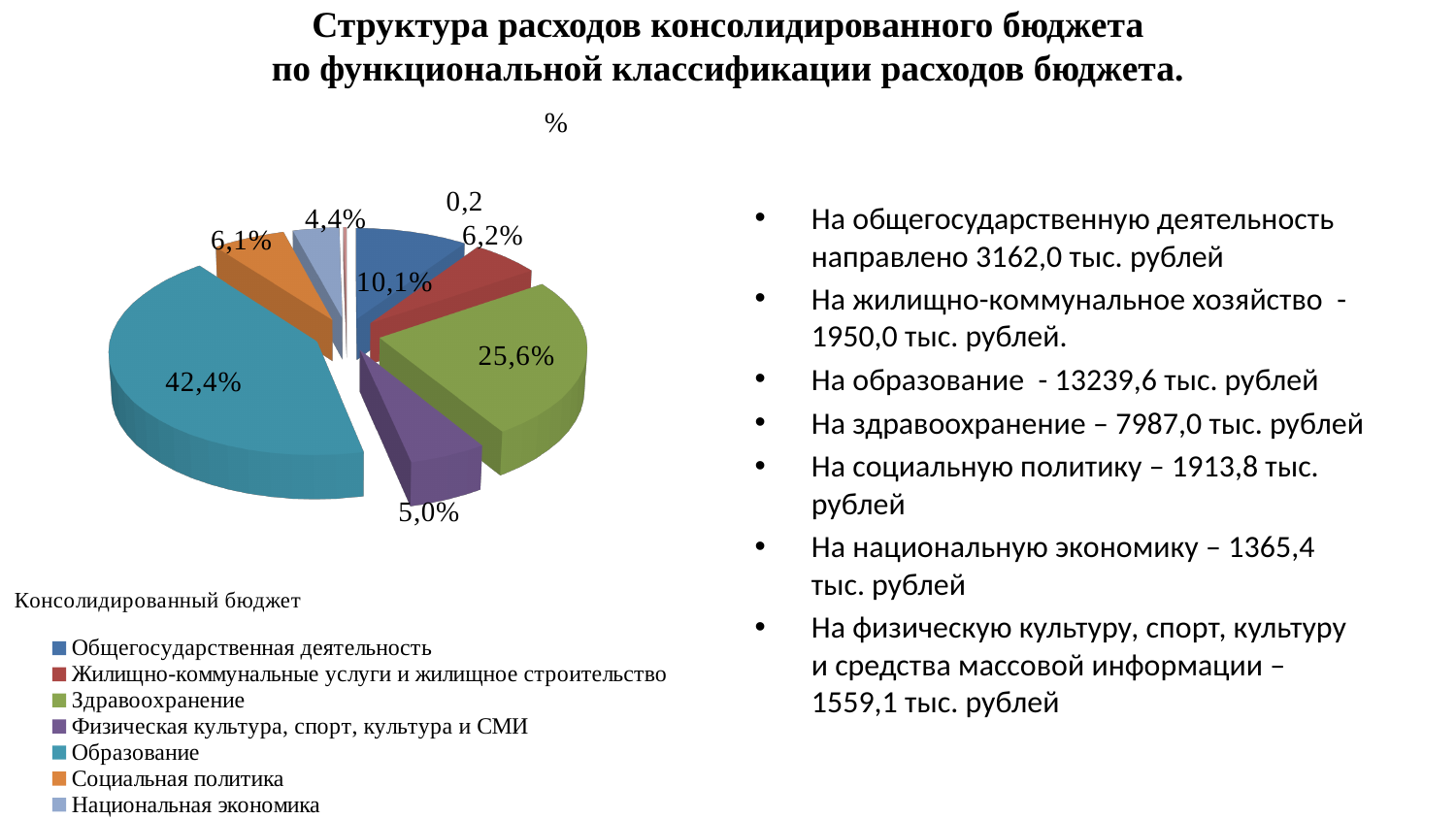
What type of chart is shown on the slide? Pie chart What percentage does the pie chart show for Социальная политика? 6,1% What percentage is shown for Национальная экономика? 4,4% How many categories does the chart legend list? 7 What is the share of Общегосударственная деятельность in the pie chart? 10,1% What share is labelled for Жилищно-коммунальные услуги и жилищное строительство? 6,2% Which has a larger share: Физическая культура, спорт, культура и СМИ or Национальная экономика? Физическая культура, спорт, культура и СМИ Which has a larger share: Здравоохранение or Общегосударственная деятельность? Здравоохранение Which category has the largest slice in the pie chart? Образование What percentage is shown for Здравоохранение in the pie chart? 25,6% By how many percentage points does the share of Образование exceed that of Здравоохранение? 16,8 What share of the pie chart does Образование account for? 42,4%